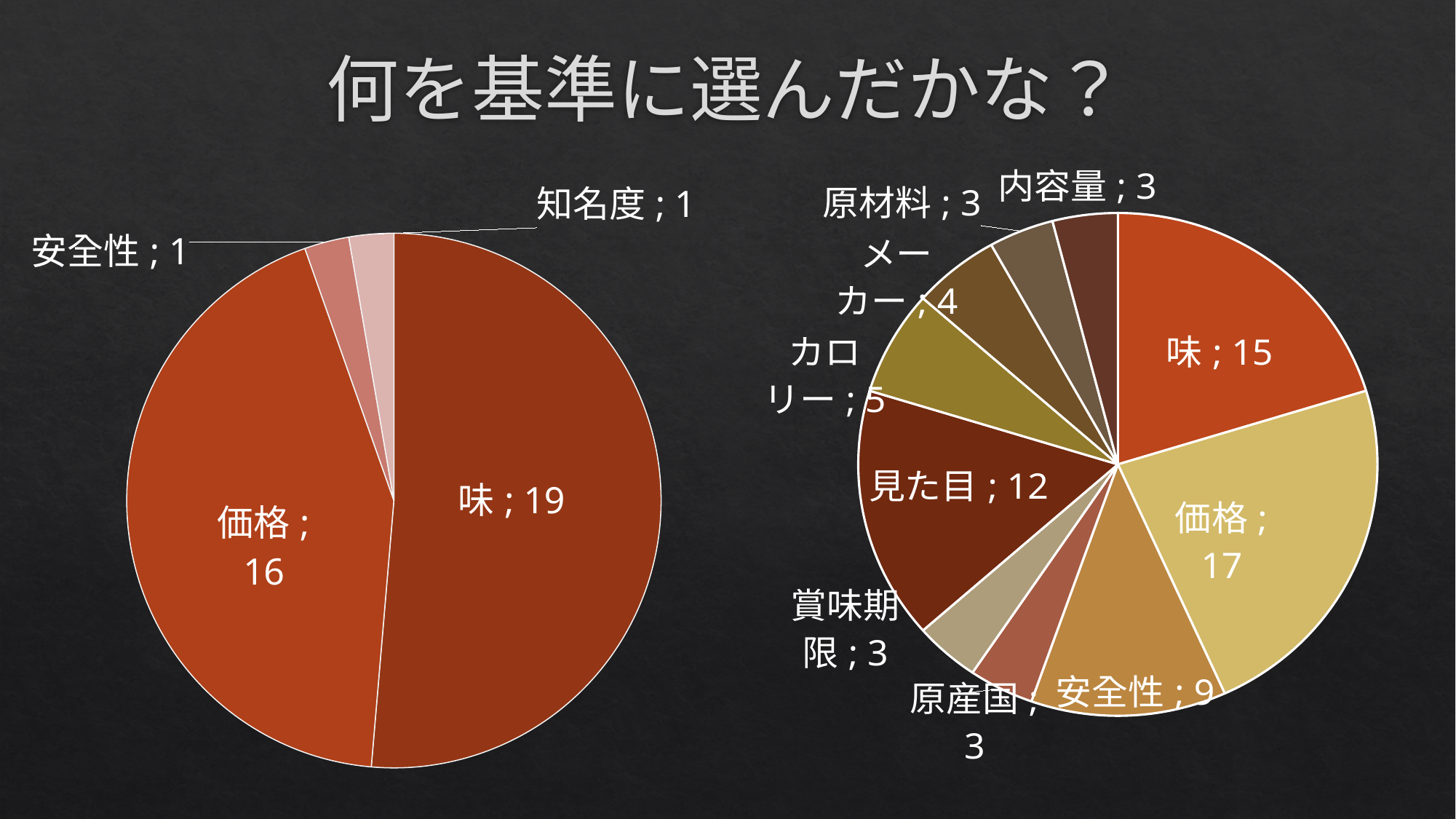
In the left pie chart, what is the value for 価格? 16 What kind of chart is the chart on the left of the slide? pie chart How many slices does the right pie chart have? 10 In the left pie chart, what is the value for 味? 19 In the right pie chart, what is the difference between 価格 and 見た目? 5 In the left pie chart, what is the difference between 味 and 価格? 3 In the right pie chart, what is the value for 見た目? 12 How many slices does the left pie chart have? 4 In the right pie chart, what is the value for 安全性? 9 In the right pie chart, which category has the largest slice? 価格 In the left pie chart, which category has the largest slice? 味 In the right pie chart, which is larger, 味 or 価格? 価格